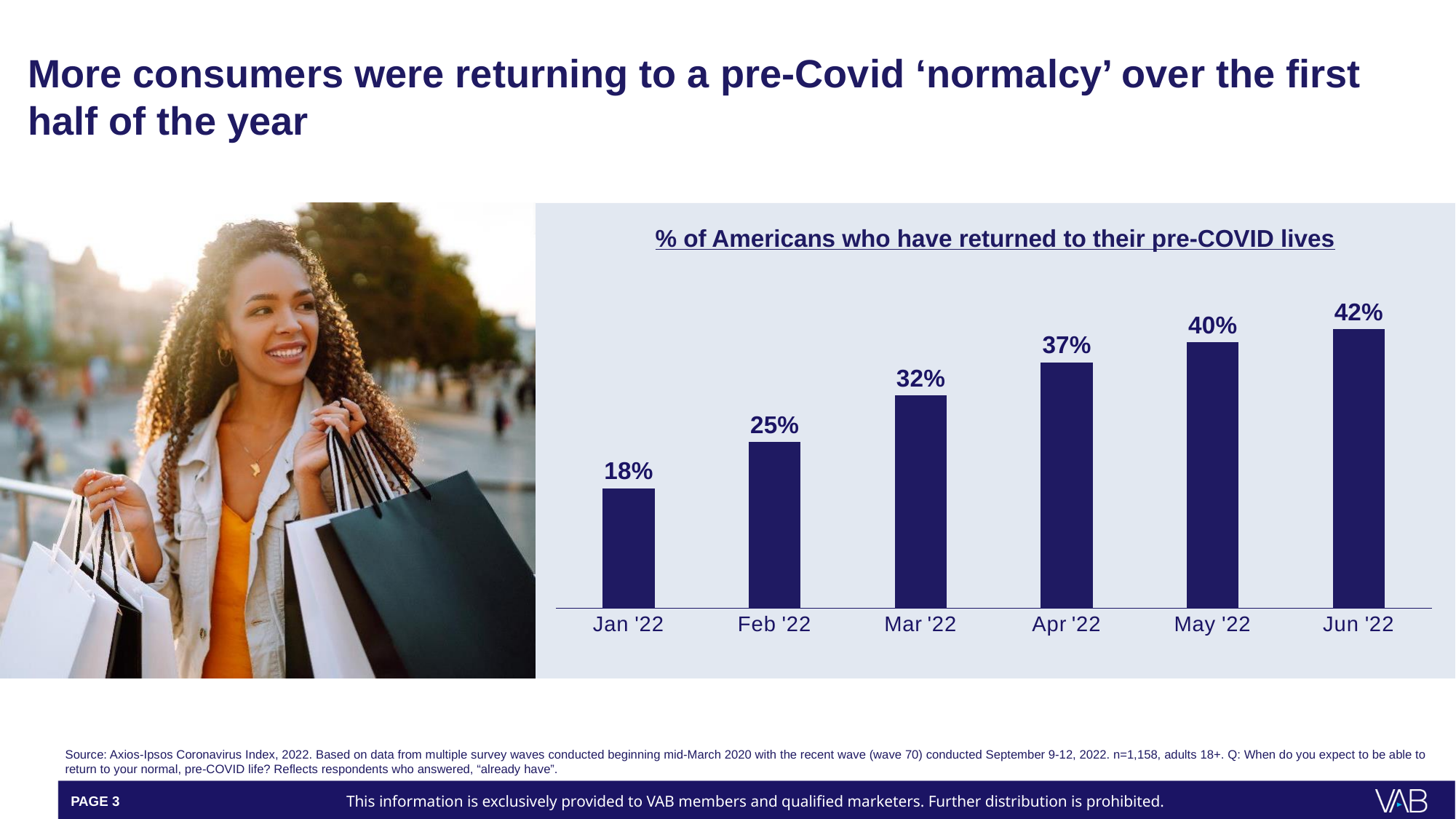
Which month has the lowest percentage? Jan '22 Which is larger, the value for Mar '22 or the value for May '22? May '22 Which month has the highest percentage of Americans who have returned to their pre-COVID lives? Jun '22 By how many percentage points did the value increase from Feb '22 to Mar '22? 7 percentage points What percentage of Americans had returned to their pre-COVID lives in Jan '22? 18% What is the title of the chart? % of Americans who have returned to their pre-COVID lives Do the values rise or fall from Jan '22 to Jun '22? Rise How many months are shown on the chart? 6 What is the difference between the values for Jun '22 and Jan '22? 24 percentage points What kind of chart is shown on the slide? Bar chart What is the value shown for Jun '22? 42% What is the value shown for Apr '22? 37%